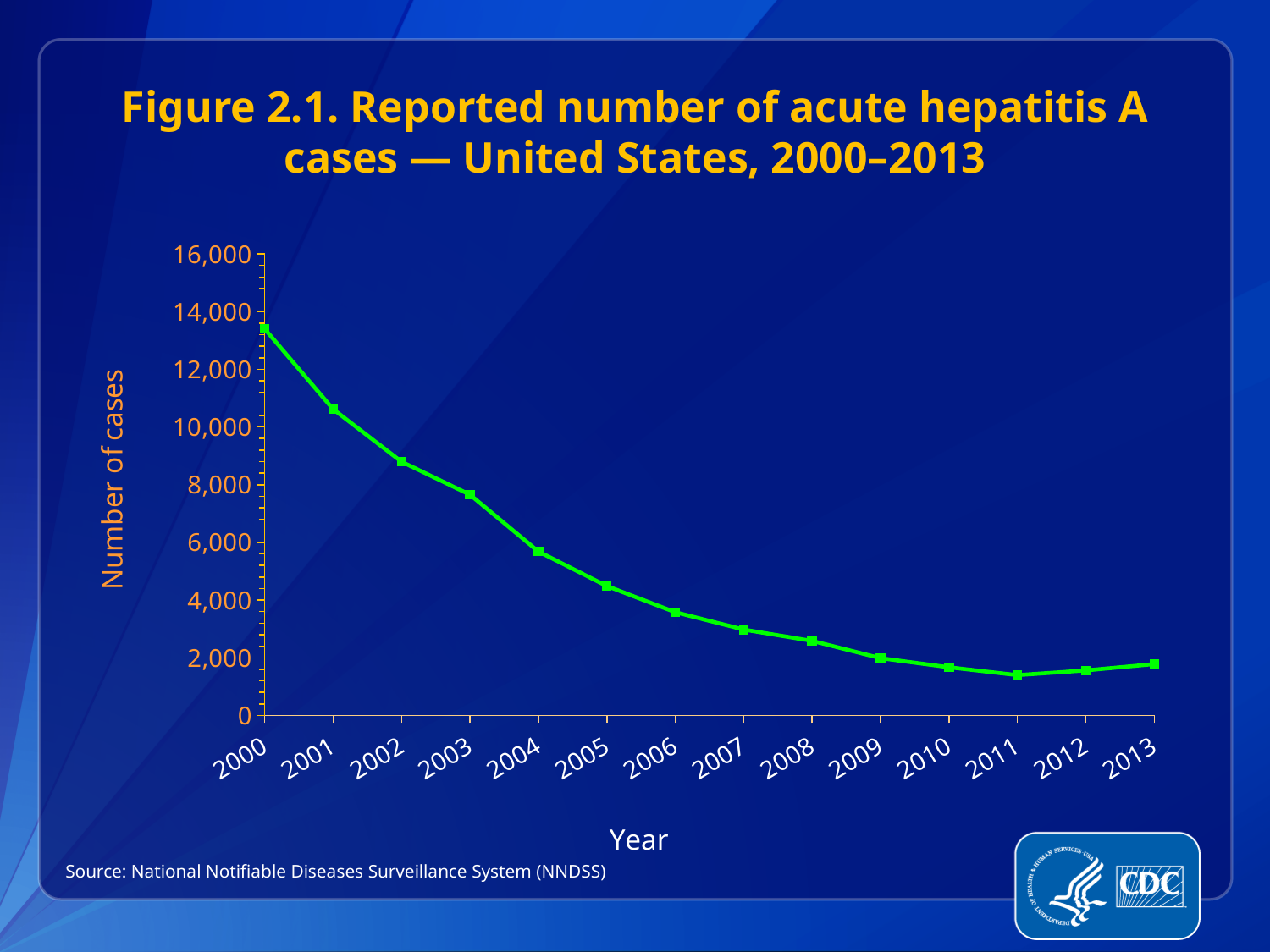
What is the source of the data cited on the slide? National Notifiable Diseases Surveillance System (NNDSS) Which year has more reported cases, 2003 or 2006? 2003 How many years (data points) are plotted on the chart? 14 What is the label on the vertical axis? Number of cases Is the value for 2000 greater or less than 12,000? greater Is the value for 2005 greater or less than 4,000? greater Which year has the highest reported number of acute hepatitis A cases? 2000 Is the value for 2011 greater or less than 2,000? less What kind of chart is shown on the slide? line chart Which year has the lowest reported number of acute hepatitis A cases? 2011 Do the reported cases generally rise or fall from 2000 to 2011? fall